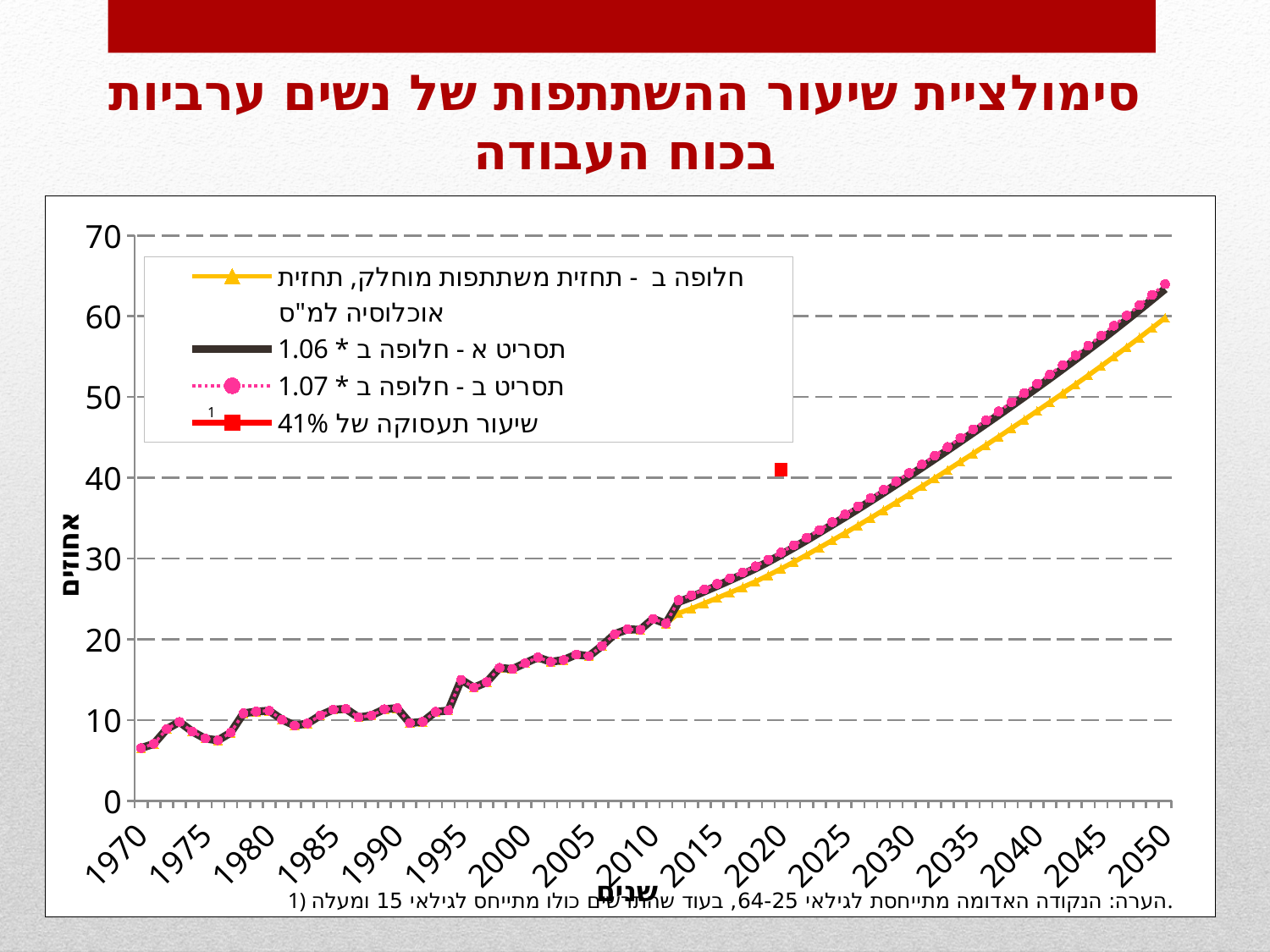
In 2050, which is larger: the value of תסריט ב - חלופה ב * 1.07 or the value of חלופה ב (yellow line)? תסריט ב - חלופה ב * 1.07 Is the value of the lines in 1970 greater or less than 10? less Which series has the highest value in 2050? תסריט ב - חלופה ב * 1.07 What kind of chart is shown on the slide? line chart Is the value of תסריט ב - חלופה ב * 1.07 in 2035 greater or less than 40? greater What is the label of the y axis? אחוזים Do the plotted lines generally rise or fall from 1970 to 2050? rise How many series does the legend list? 4 Is the value of תסריט ב - חלופה ב * 1.07 in 2050 greater or less than 60? greater What is the label of the x axis? שנים What value does the red square marker (שיעור תעסוקה) represent, according to the legend? 41%